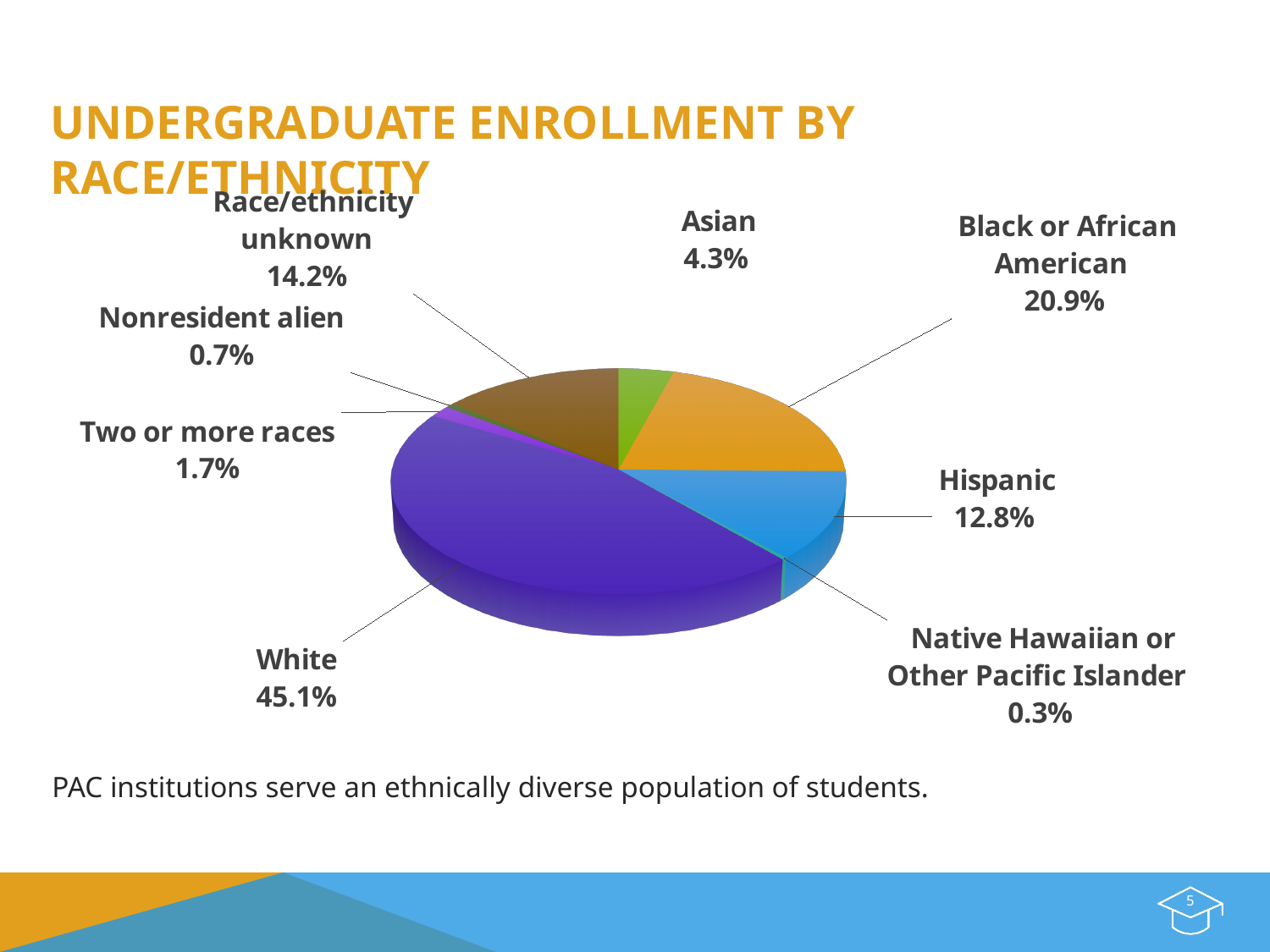
Which is larger, the share for Race/ethnicity unknown or the share for Hispanic? Race/ethnicity unknown What is the title of the chart on the slide? Undergraduate Enrollment by Race/Ethnicity Which race/ethnicity category has the smallest share of undergraduate enrollment? Native Hawaiian or Other Pacific Islander What is the difference in percentage points between the Black or African American share and the Hispanic share? 8.1 What kind of chart is shown on the slide? Pie chart What share of undergraduate enrollment is Black or African American? 20.9% What share of undergraduate enrollment is Hispanic? 12.8% What share of undergraduate enrollment is White? 45.1% What share of undergraduate enrollment is Native Hawaiian or Other Pacific Islander? 0.3% How many race/ethnicity categories are shown in the pie chart? 8 Which race/ethnicity category has the largest share of undergraduate enrollment? White What share of undergraduate enrollment is Race/ethnicity unknown? 14.2%